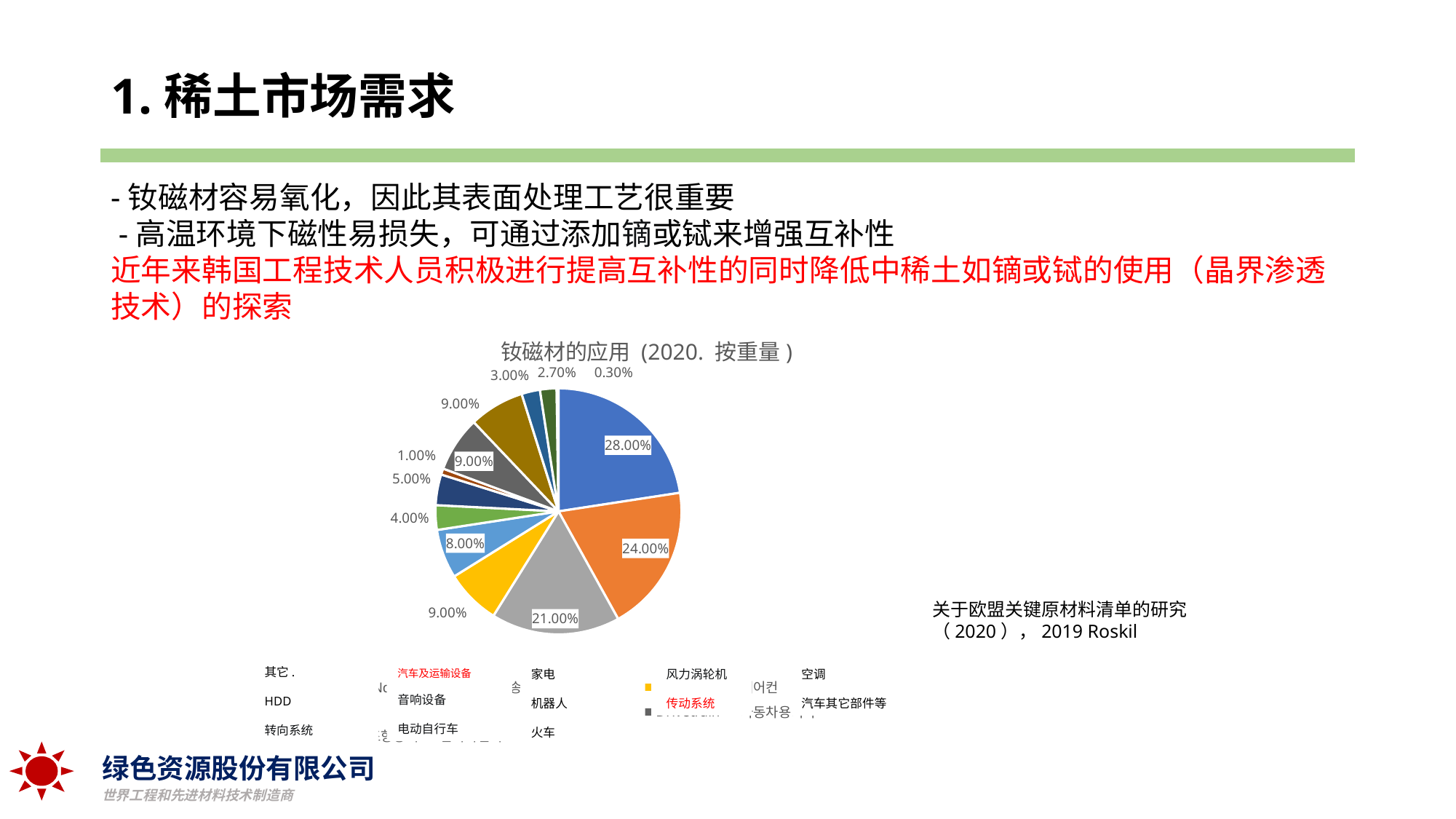
What is the difference between the largest slice (28.00%) and the second largest slice (24.00%)? 4.00% What is the title of the pie chart? 钕磁材的应用（2020. 按重量） Which slice is larger, the blue slice or the orange slice? the blue slice What is the difference between the slice labelled 21.00% and the slice labelled 8.00%? 13.00% What is the difference between the slice labelled 2.70% and the slice labelled 0.30%? 2.40% What is the value of the largest slice in the pie chart? 28.00% What value is labelled on the gray slice at the bottom of the pie chart? 21.00% Which is larger, the orange slice labelled 24.00% or the gray slice labelled 21.00%? 24.00% What is the value of the smallest slice in the pie chart? 0.30% How many slices does the pie chart have? 13 What colour is the largest slice of the pie chart? blue What kind of chart is shown on the slide? pie chart